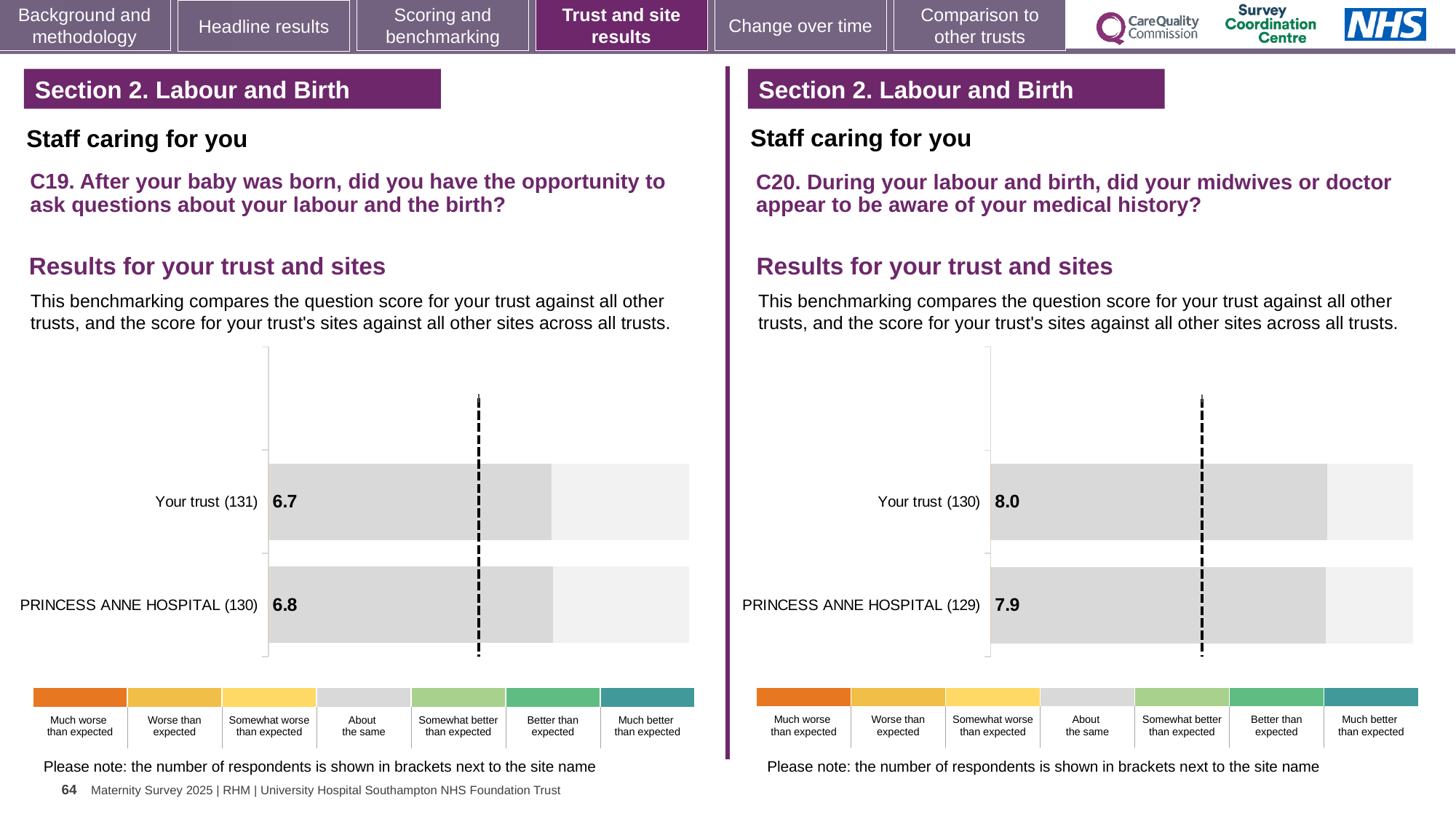
In the C20 chart on the right, how many respondents are shown in brackets for PRINCESS ANNE HOSPITAL? 129 In the C19 chart on the left, how many respondents are shown in brackets for Your trust? 131 How many bars are plotted in the C19 chart on the left? 2 In the C20 chart on the right, what is the score for PRINCESS ANNE HOSPITAL? 7.9 In the C20 chart on the right, what is the difference between the Your trust score and the PRINCESS ANNE HOSPITAL score? 0.1 In the C20 chart on the right, which has the higher score, Your trust or PRINCESS ANNE HOSPITAL? Your trust What type of chart is used for the C20 results on the right? Bar chart In the C19 chart on the left, what is the difference between the PRINCESS ANNE HOSPITAL score and the Your trust score? 0.1 In the C20 chart on the right, what is the score for Your trust? 8.0 In the C19 chart on the left, which has the higher score, Your trust or PRINCESS ANNE HOSPITAL? PRINCESS ANNE HOSPITAL In the C19 chart on the left, what is the score for PRINCESS ANNE HOSPITAL? 6.8 In the C19 chart on the left, what is the score for Your trust? 6.7